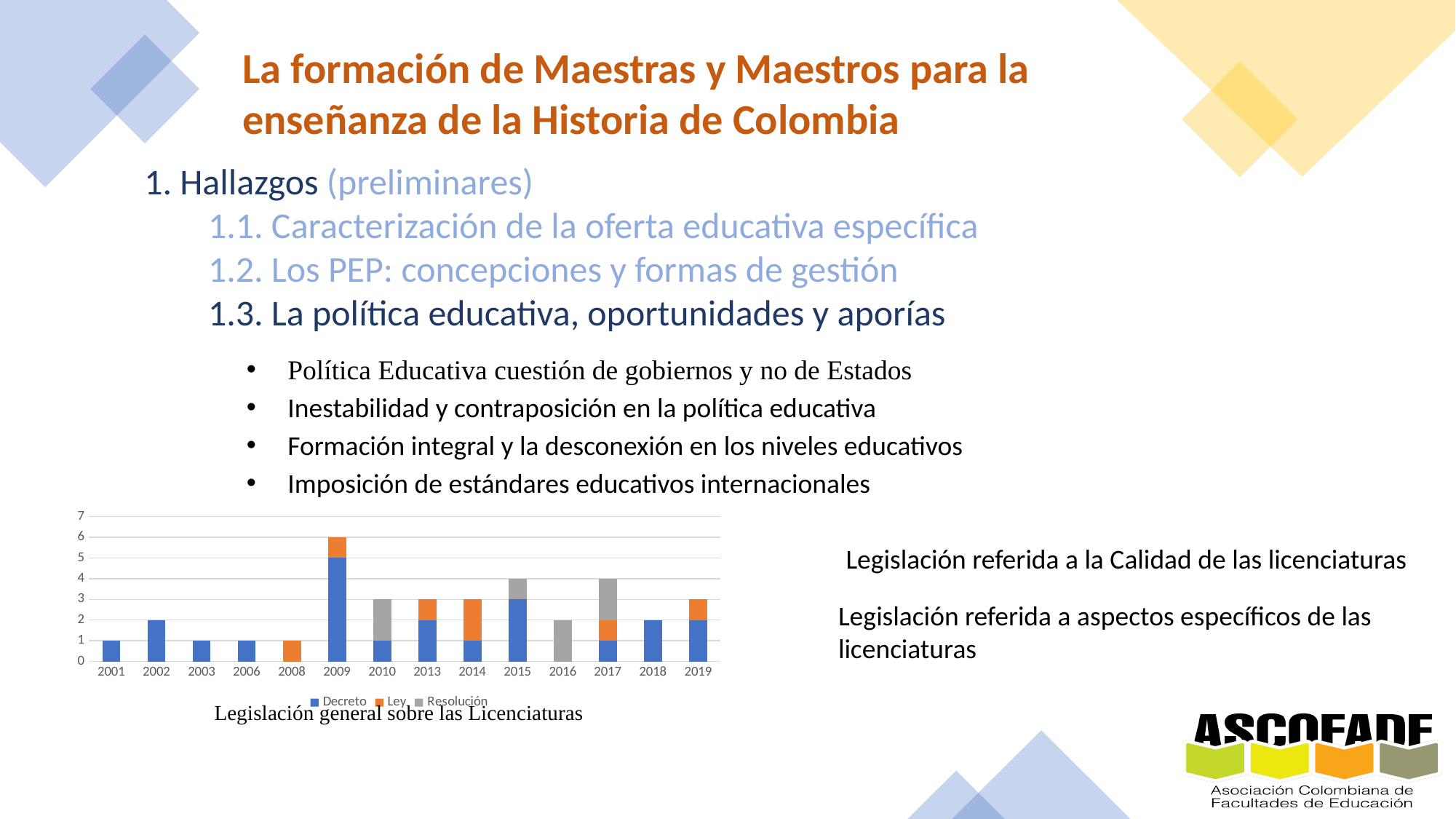
How many years are shown on the x axis of the chart? 14 What is the value for Decreto in 2009? 5 What is the total height of the stacked bar for 2009? 6 Which year has the tallest stacked bar in the chart? 2009 What is the difference between the total bar for 2009 and the total bar for 2002? 4 Is the total for 2009 greater or less than 5? greater Which is larger, the total bar for 2015 or the total bar for 2016? 2015 What is the total height of the stacked bar for 2017? 4 What kind of chart is shown on the slide? stacked bar chart Which series are listed in the chart legend? Decreto, Ley, Resolución What is the value for Decreto in 2015? 3 How many series does the chart legend list? 3